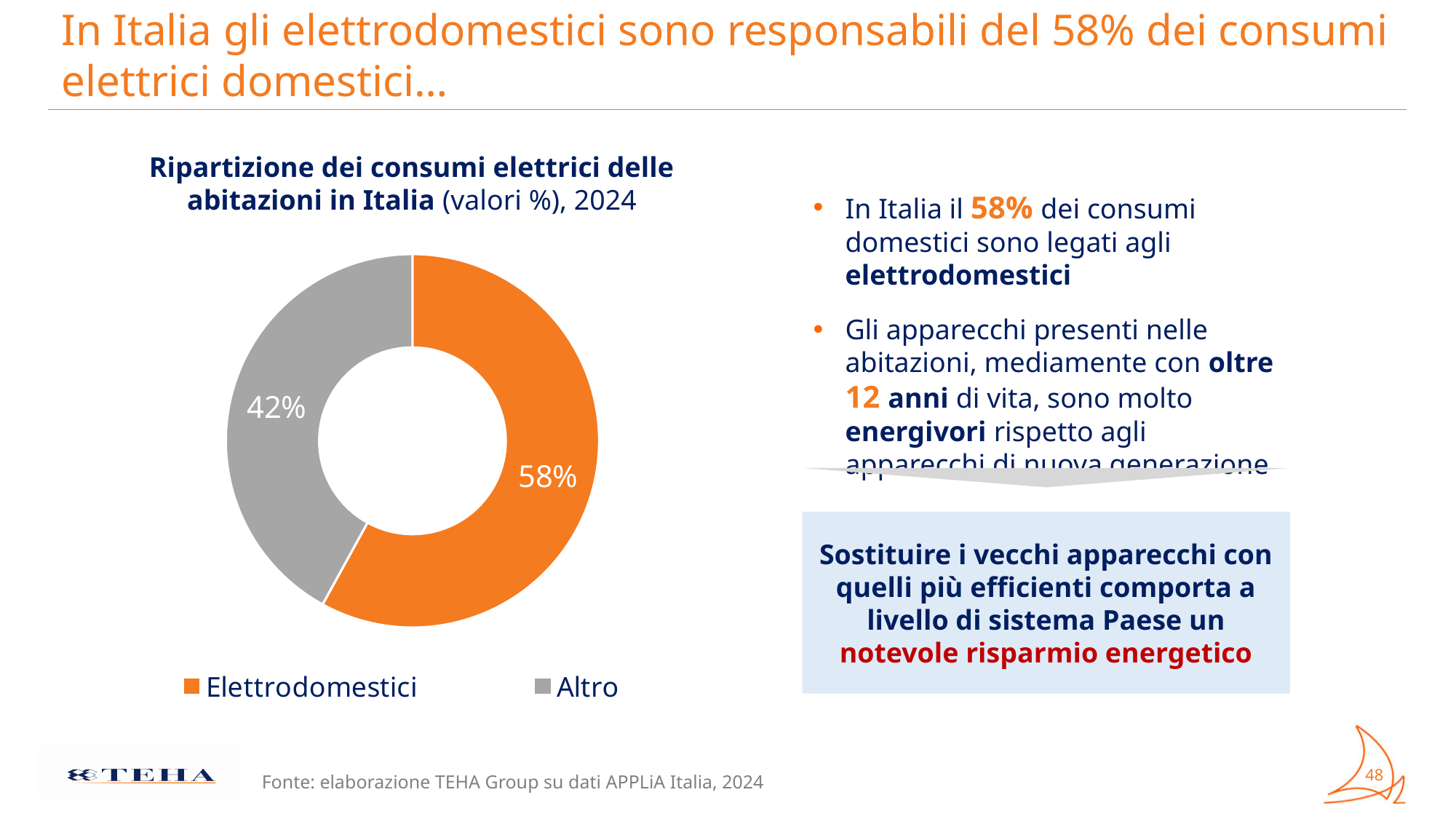
What is the combined share of Elettrodomestici and Altro? 100% How many categories does the chart show? 2 What share of household electricity consumption in Italy is attributed to Altro? 42% Which category has the larger share of household electricity consumption? Elettrodomestici Is the share for Elettrodomestici larger or smaller than the share for Altro? larger By how many percentage points does the Elettrodomestici share exceed the Altro share? 16 Which colour represents Elettrodomestici in the chart? Orange What year does the chart refer to? 2024 What kind of chart is shown on the slide? Doughnut (pie) chart Which category has the smaller share of household electricity consumption? Altro What share of household electricity consumption in Italy is attributed to Elettrodomestici? 58%